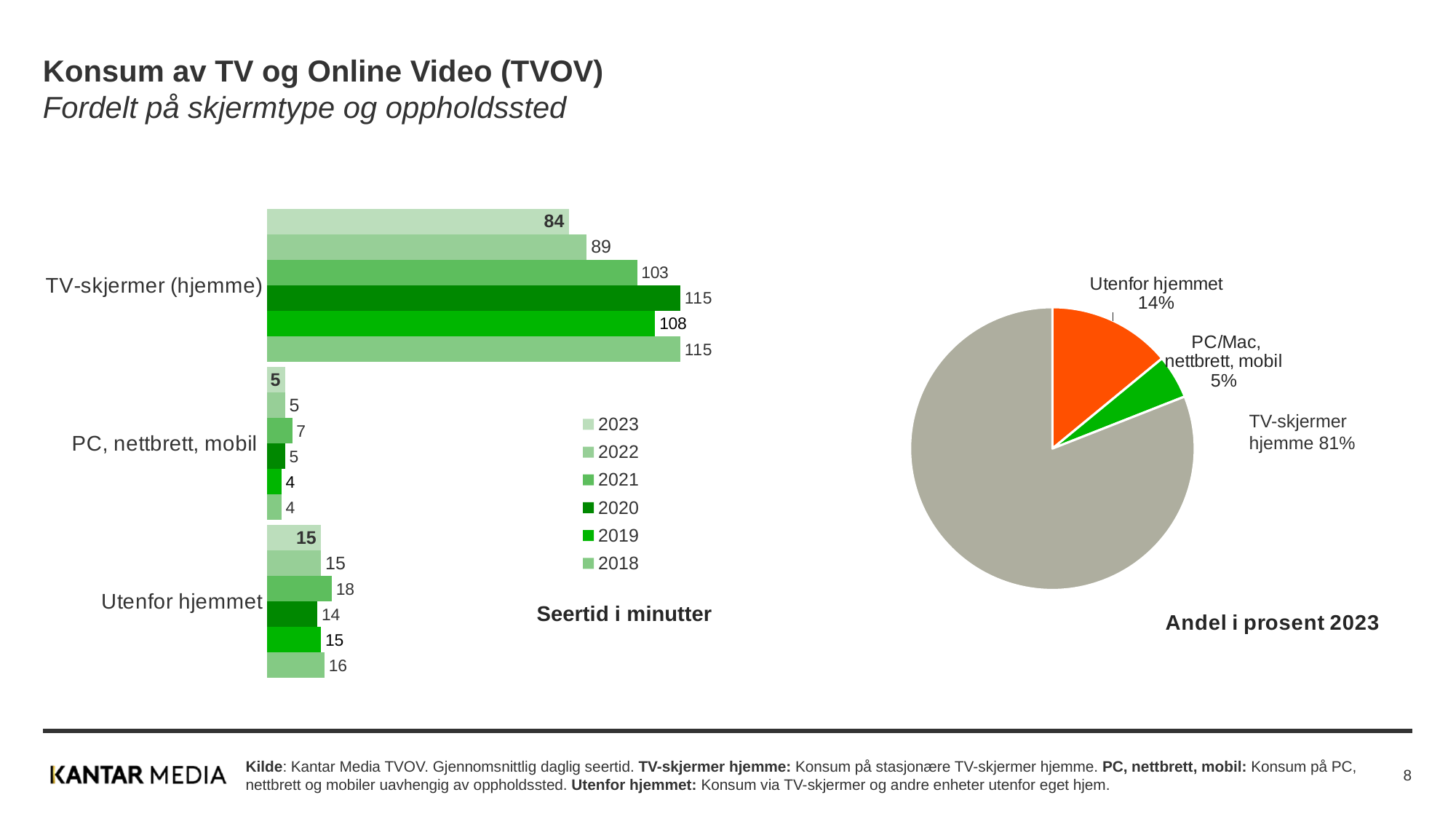
In the 'Seertid i minutter' chart, what is the 2021 value for Utenfor hjemmet? 18 In the 'Seertid i minutter' chart, what is the difference between the 2020 and 2023 values for TV-skjermer (hjemme)? 31 In the 'Seertid i minutter' chart, what is the 2023 value for TV-skjermer (hjemme)? 84 In the 'Andel i prosent 2023' pie chart, which slice is the largest? TV-skjermer hjemme In the 'Andel i prosent 2023' pie chart, what share does Utenfor hjemmet have? 14% How many categories are shown in the 'Seertid i minutter' chart? 3 What kind of chart is 'Andel i prosent 2023'? Pie chart In the 'Seertid i minutter' chart, which year has the lowest value for TV-skjermer (hjemme)? 2023 In the 'Seertid i minutter' chart, which is larger for TV-skjermer (hjemme): the 2021 value or the 2019 value? 2019 How many series does the legend of the 'Seertid i minutter' chart list? 6 In the 'Seertid i minutter' chart, what is the 2019 value for PC, nettbrett, mobil? 4 What kind of chart is 'Seertid i minutter'? Bar chart